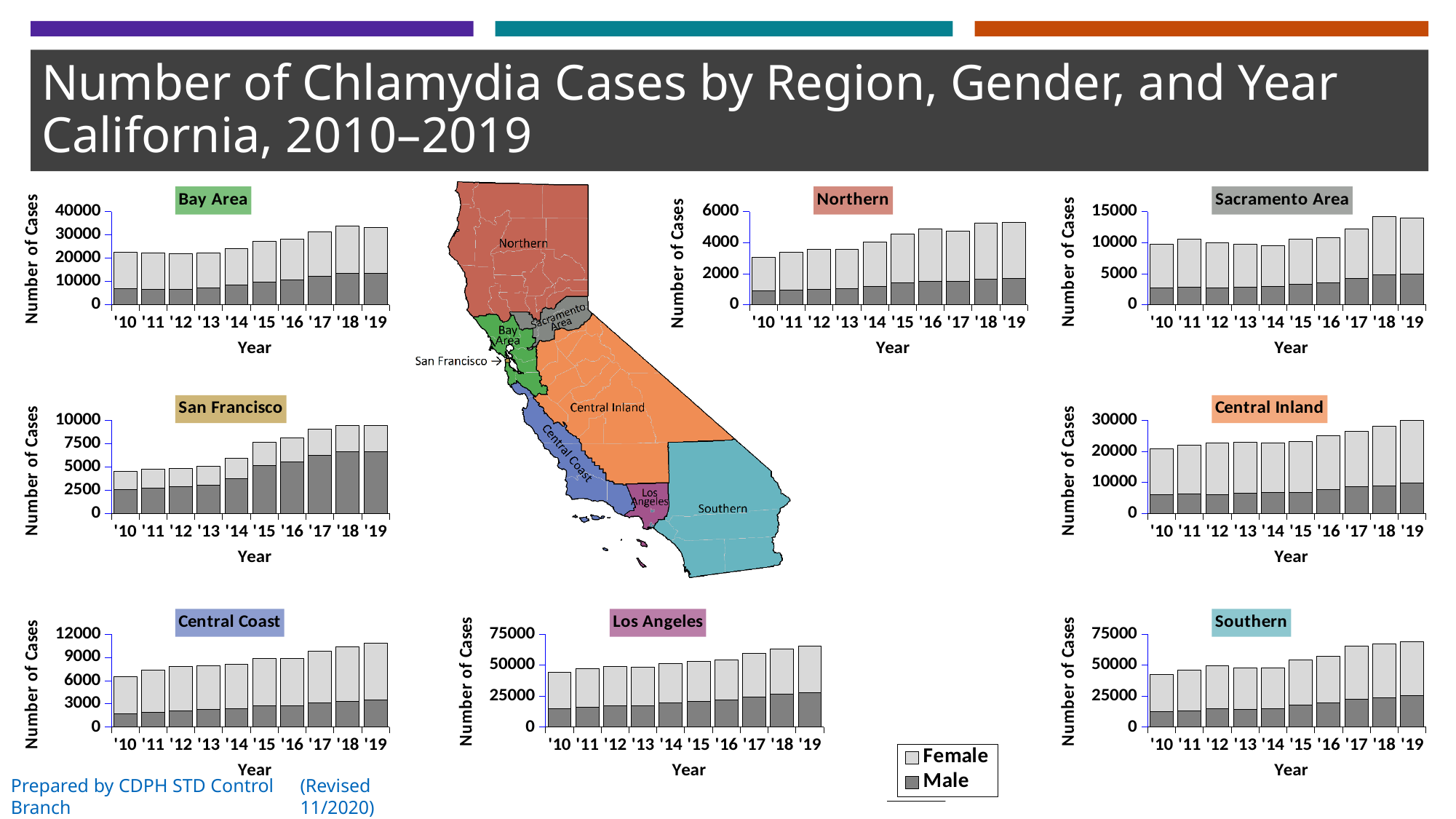
In the Bay Area chart for '19, which is larger, the Female or the Male segment? Female What kind of chart is the Bay Area chart? bar chart In the Central Inland chart, which year has the highest total number of cases? '19 How many years are shown on the x axis of the Northern chart? 10 In the Central Coast chart, which year has the lowest total number of cases? '10 In the Sacramento Area chart, do the total cases generally rise or fall from '10 to '19? rise In the Los Angeles chart, is the total number of cases for '19 greater or less than 50000? greater In the San Francisco chart, is the total number of cases for '19 greater or less than 7500? greater In the Northern chart, is the total number of cases for '10 greater or less than 4000? less What are the two series named in the legend? Female and Male How many series does the legend list? 2